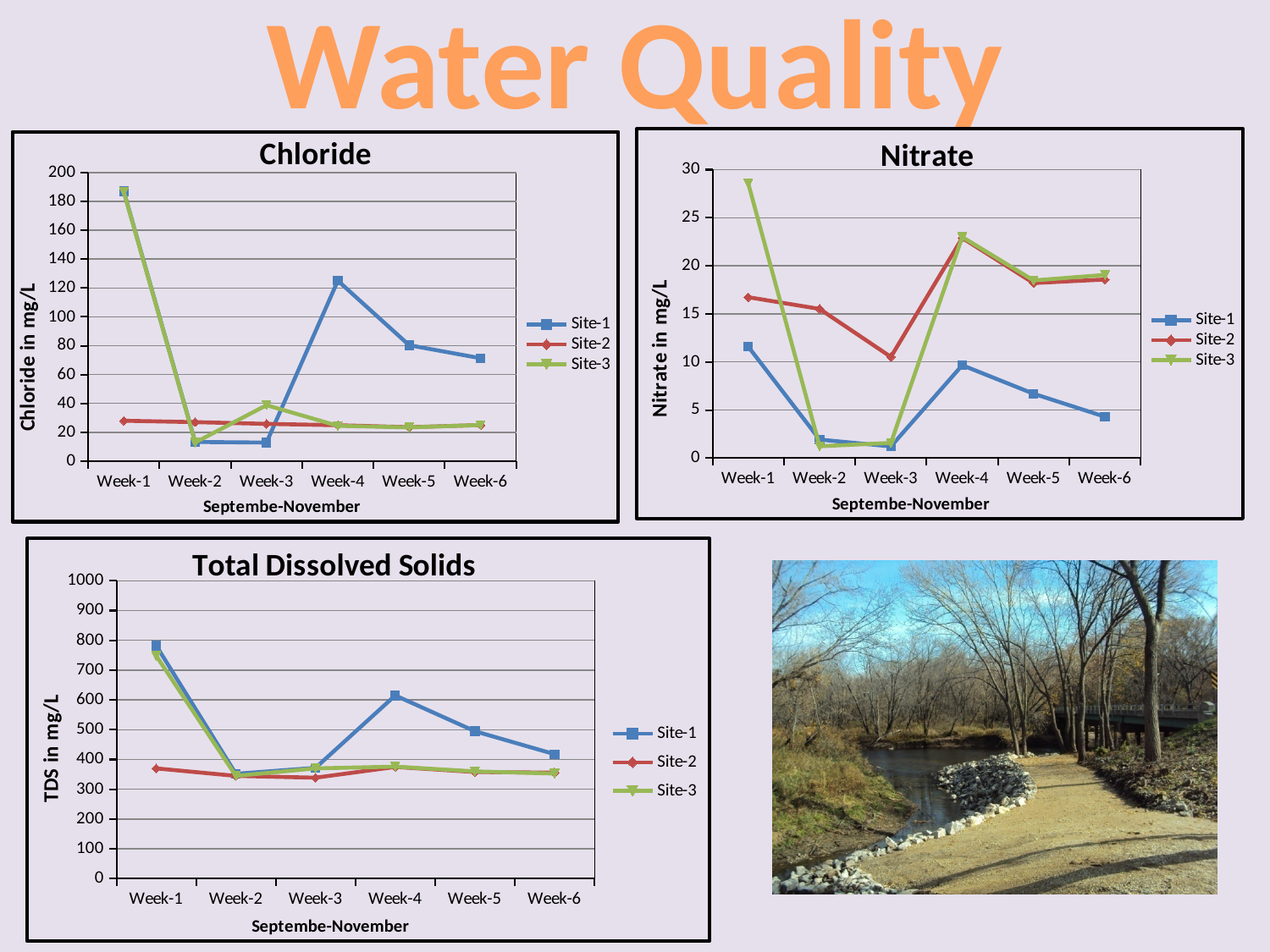
In the Nitrate chart, is the value for Site-3 at Week-1 greater or less than 25? greater In the Chloride chart, at which week does Site-1 reach its highest value? Week-1 How many weeks are shown on the x axis of the Total Dissolved Solids chart? 6 In the Total Dissolved Solids chart, is the value for Site-1 at Week-1 greater or less than 700? greater In the Nitrate chart, does the Site-1 line rise or fall from Week-4 to Week-6? fall In the Chloride chart, which is larger at Week-4: Site-1 or Site-2? Site-1 In the Nitrate chart, is the value for Site-1 at Week-6 greater or less than 5? less In the Total Dissolved Solids chart, which is larger at Week-4: Site-1 or Site-3? Site-1 How many series does the legend of the Nitrate chart list? 3